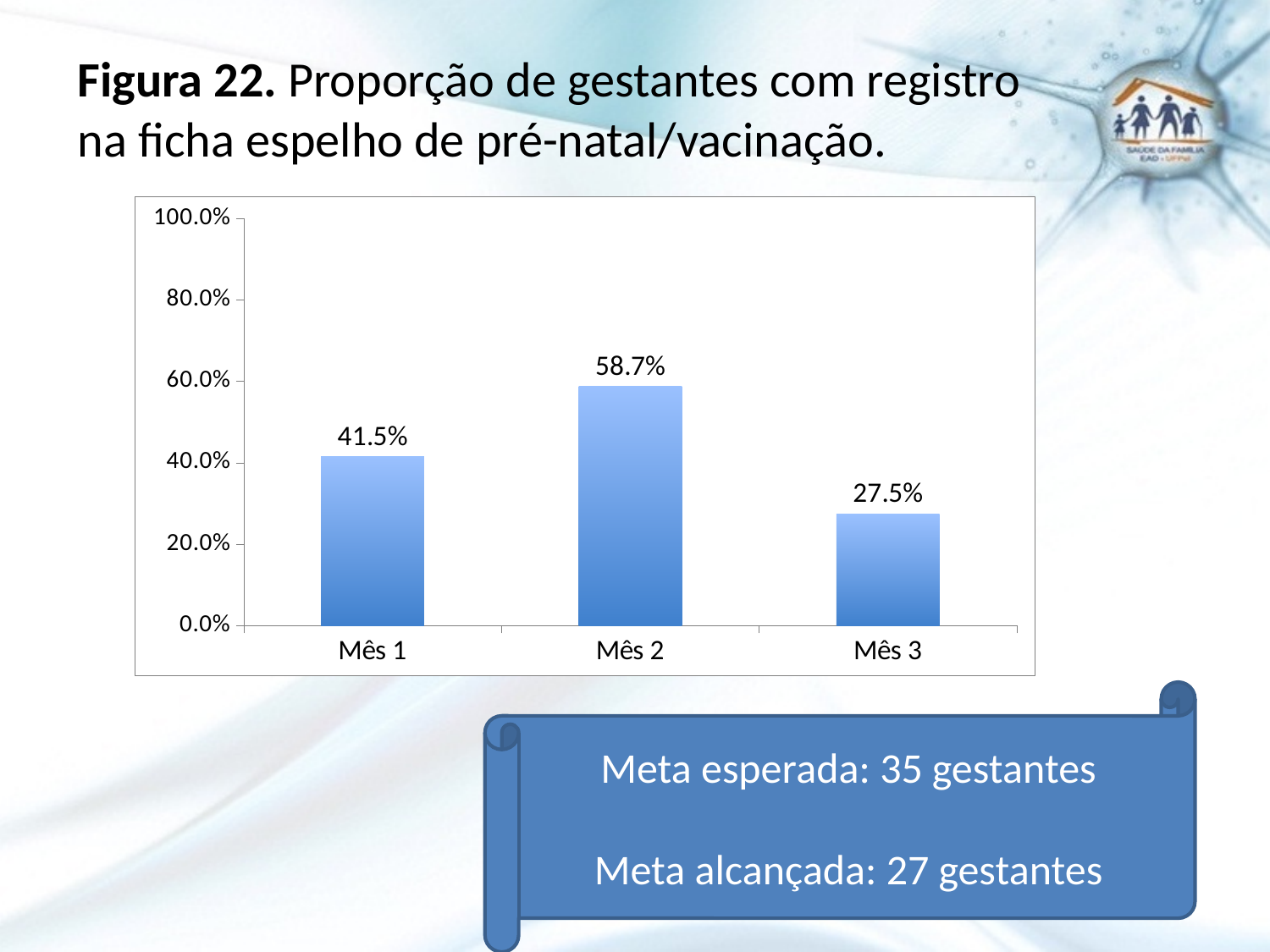
What is the difference between the values for Mês 2 and Mês 1? 17.2% Which month has the highest value? Mês 2 What is the value for Mês 3? 27.5% Which month has the lowest value? Mês 3 Which is larger, the value for Mês 1 or the value for Mês 3? Mês 1 What is the value for Mês 1? 41.5% Is the value for Mês 2 greater or less than 60.0%? less How many months are shown on the x axis? 3 What is the highest value shown on the y axis? 100.0% What kind of chart is shown on the slide? bar chart What is the value for Mês 2? 58.7% What is the difference between the values for Mês 1 and Mês 3? 14.0%